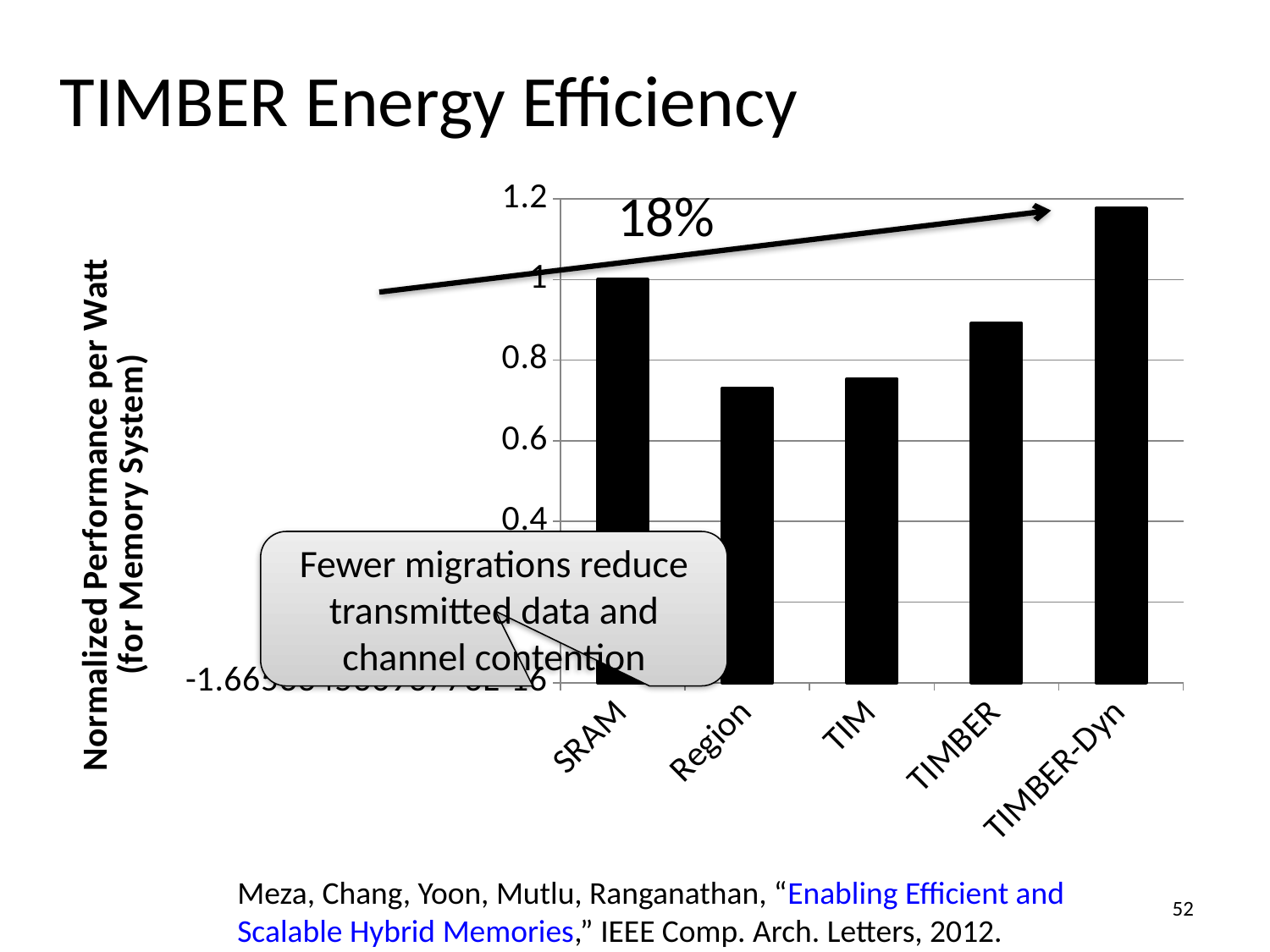
What kind of chart is shown on the slide? bar chart Which category has the highest normalized performance per watt? TIMBER-Dyn Which has a higher normalized performance per watt, TIMBER or Region? TIMBER Which has a higher normalized performance per watt, SRAM or TIM? SRAM Is the value for TIMBER greater or less than 1? less What percentage improvement is annotated with the arrow on the chart? 18% Is the value for TIMBER-Dyn greater or less than 1? greater Is the value for TIMBER greater or less than 0.8? greater What is the label of the y axis? Normalized Performance per Watt (for Memory System) How many categories are shown on the x axis of the chart? 5 What is the normalized performance per watt for SRAM? 1